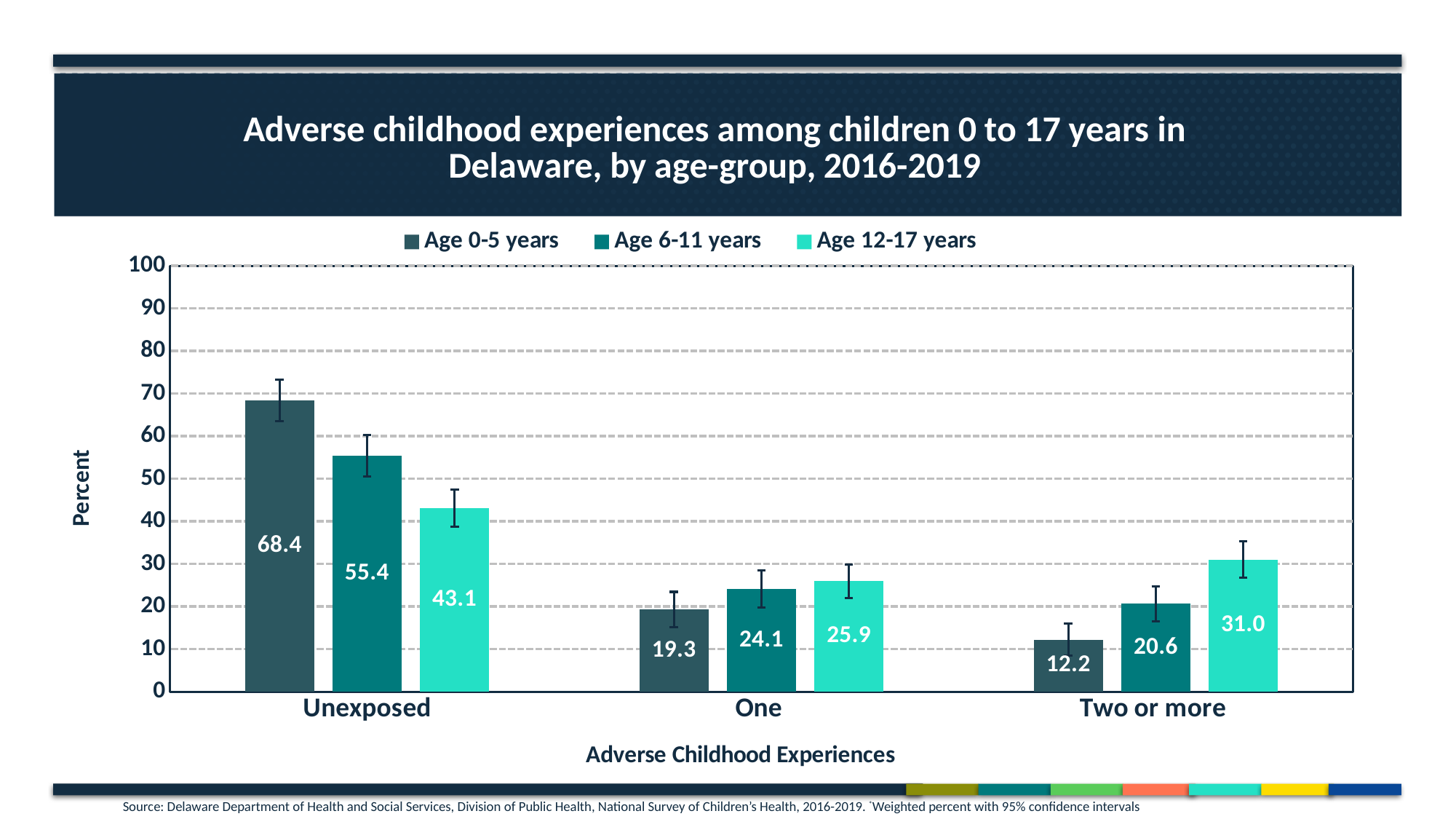
How many categories are shown on the x axis? 3 Do the Age 0-5 years values rise or fall from Unexposed to Two or more? Fall What is the label of the y axis? Percent What kind of chart is shown on the slide? Bar chart How many series does the legend list? 3 What is the value for Age 6-11 years in the One category? 24.1 What is the value for Age 12-17 years in the Two or more category? 31.0 What is the difference between the Age 0-5 years and Age 12-17 years values in the Unexposed category? 25.3 Which age group has the highest value in the Unexposed category? Age 0-5 years What is the value for Age 0-5 years in the Unexposed category? 68.4 Which age group has the lowest value in the Two or more category? Age 0-5 years Which is larger: the Age 6-11 years value for One or the Age 6-11 years value for Two or more? One